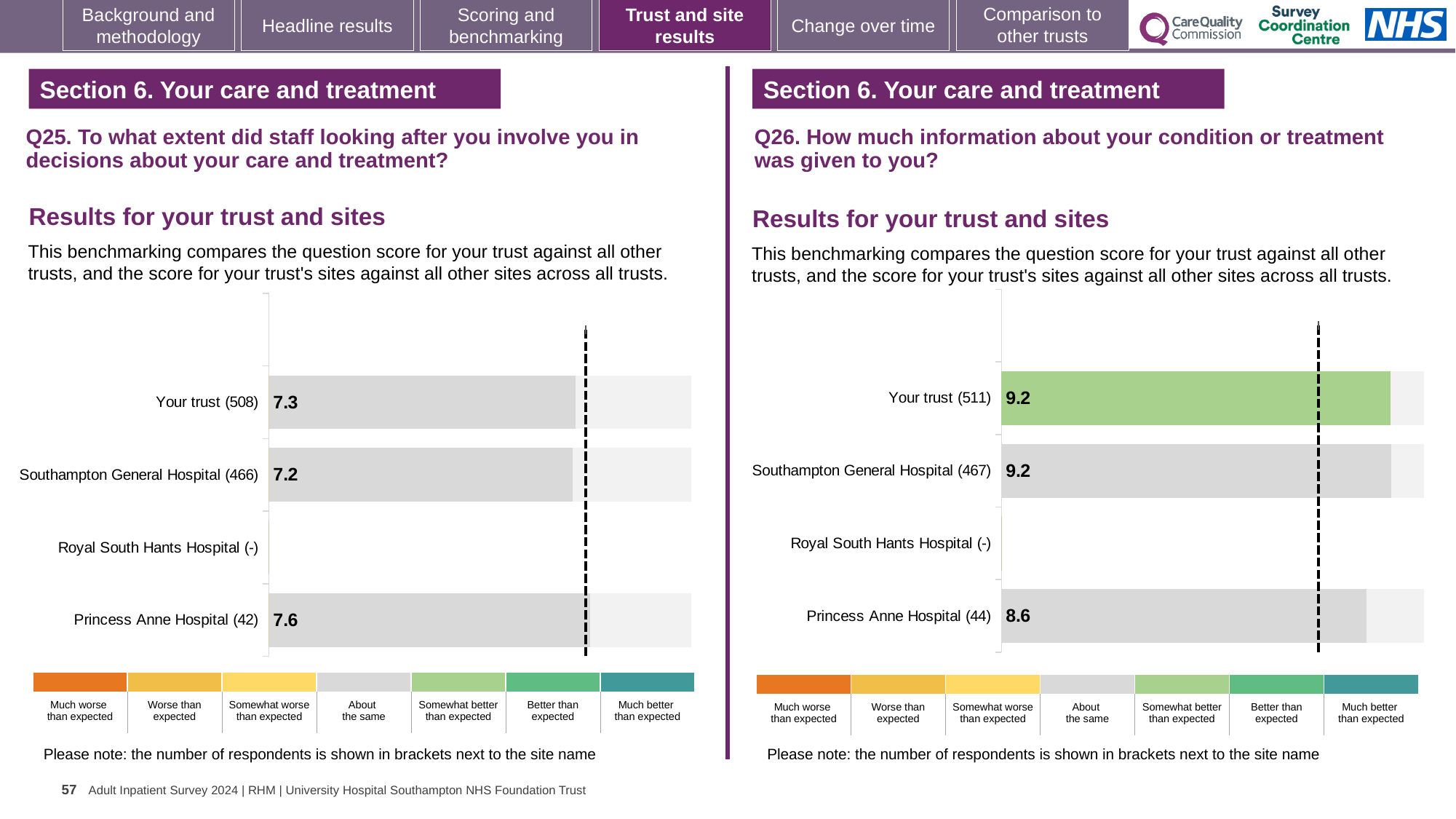
In the Q25 chart on the left, what is the difference between the scores for Princess Anne Hospital (42) and Southampton General Hospital (466)? 0.4 In the Q25 chart on the left, what is the score for Princess Anne Hospital (42)? 7.6 How many rows (sites including the trust) are listed in the Q25 chart on the left? 4 In the Q25 chart on the left, which site has the highest score? Princess Anne Hospital (42) What kind of chart is used in the Q26 chart on the right? Bar chart In the Q25 chart on the left, what is the score for Your trust (508)? 7.3 In the Q26 chart on the right, what is the difference between the scores for Southampton General Hospital (467) and Princess Anne Hospital (44)? 0.6 In the Q26 chart on the right, which benchmark category does the green colour of the Your trust (511) bar correspond to? Somewhat better than expected In the Q26 chart on the right, what is the score for Princess Anne Hospital (44)? 8.6 In the Q25 chart on the left, which site has no score shown? Royal South Hants Hospital (-) In the Q26 chart on the right, which of Your trust (511) or Princess Anne Hospital (44) has the larger score? Your trust (511) In the Q26 chart on the right, what is the score for Your trust (511)? 9.2